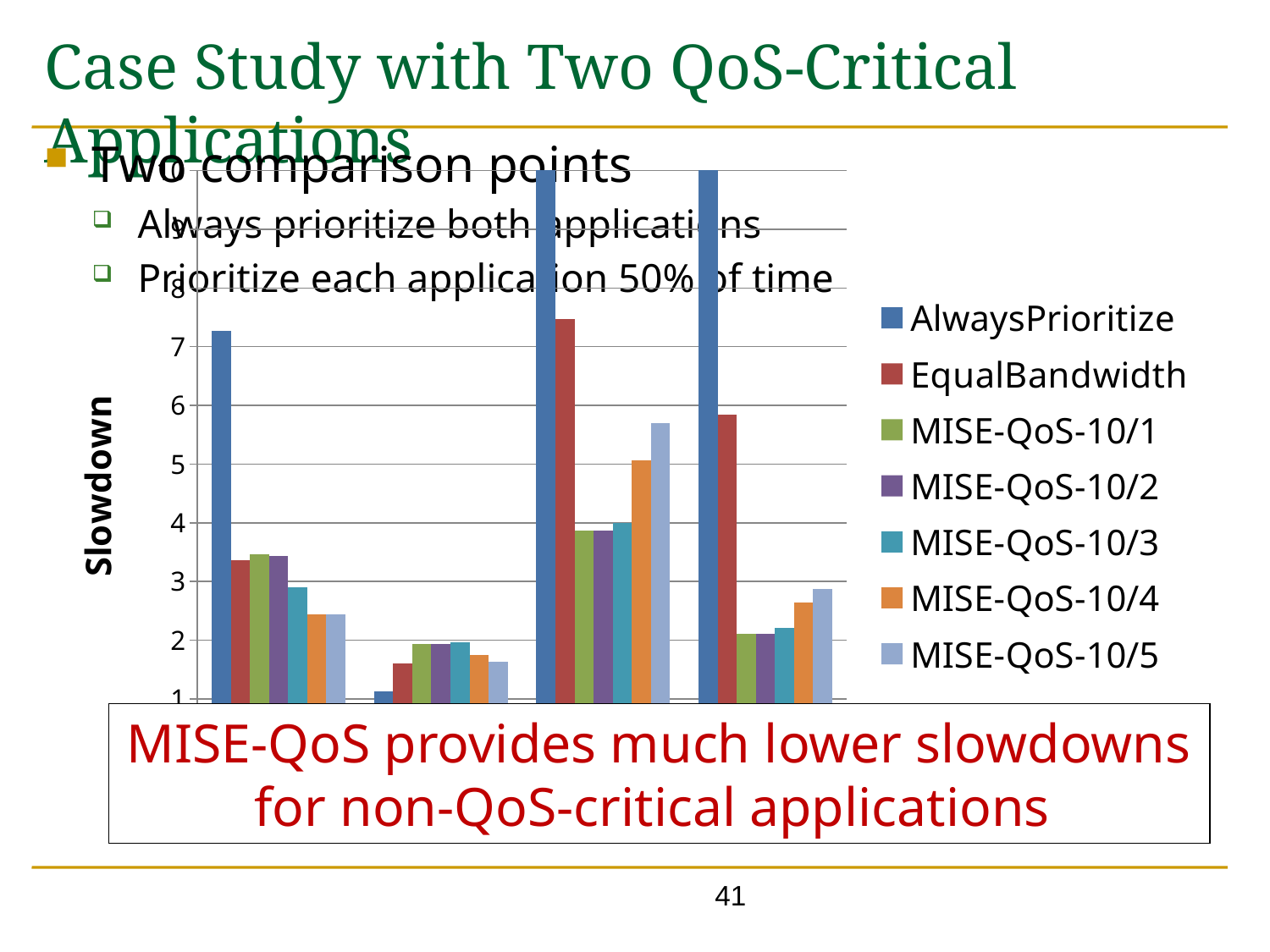
In the second group of bars from the left, is the AlwaysPrioritize value greater or less than 2? less How many groups of bars are plotted in the chart? 4 In the rightmost group of bars, is the MISE-QoS-10/1 value greater or less than 3? less Which series is listed first in the chart's legend? AlwaysPrioritize What kind of chart is shown on the slide? bar chart In the third group of bars from the left, is the EqualBandwidth value greater or less than 7? greater In the leftmost group of bars, which is larger: the AlwaysPrioritize value or the EqualBandwidth value? AlwaysPrioritize How many series does the chart's legend list? 7 What is the title of the chart's vertical axis? Slowdown In the third group of bars from the left, which series has the highest slowdown? AlwaysPrioritize